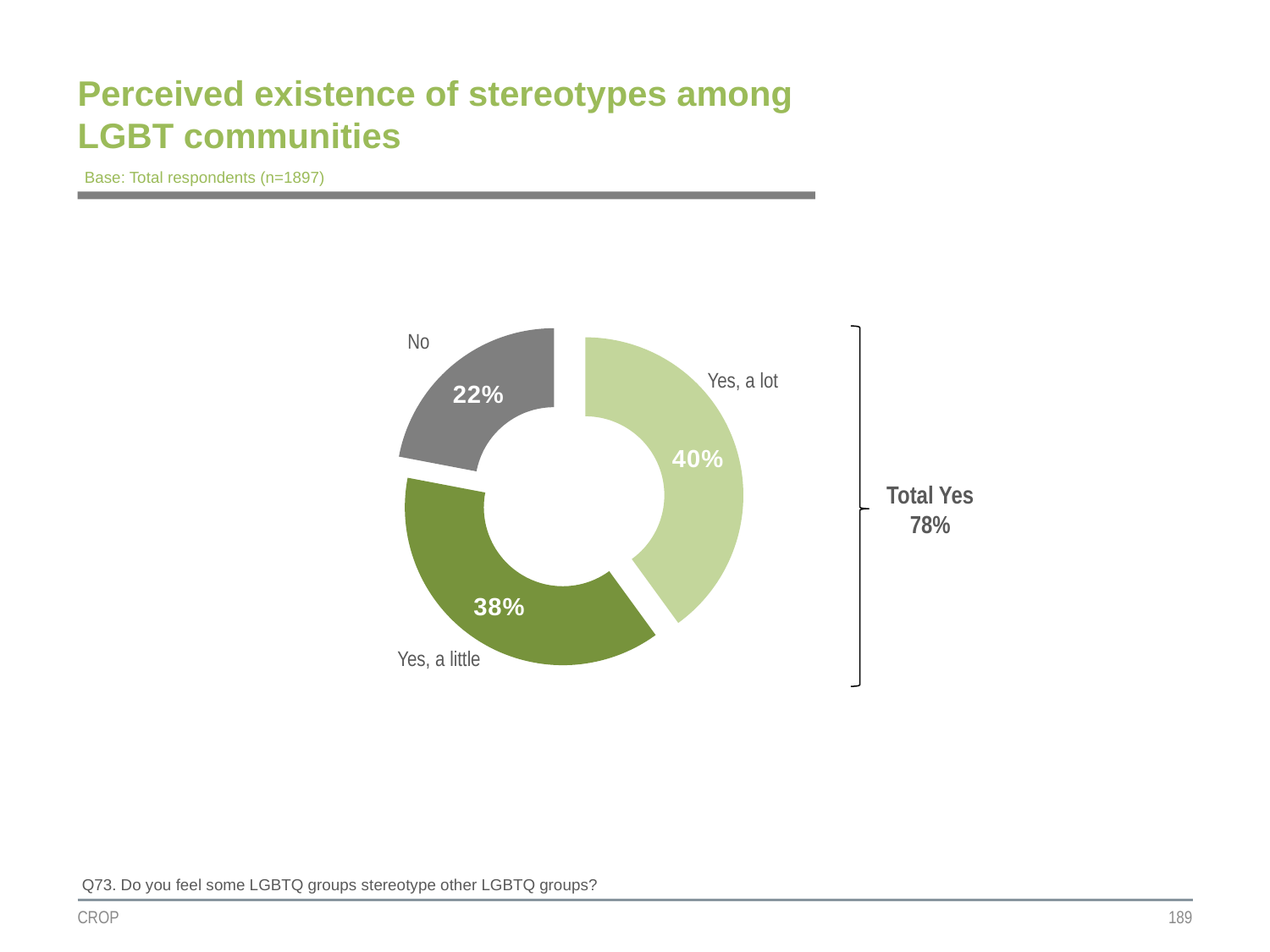
What is the title of the chart on the slide? Perceived existence of stereotypes among LGBT communities How many response categories are shown in the chart? 3 What kind of chart is shown on the slide? Doughnut (pie) chart Which response category has the largest share? Yes, a lot Which is larger, the share for "Yes, a little" or the share for "No"? Yes, a little What is the difference in percentage points between "Yes, a lot" and "No"? 18 What percentage of respondents answered "Yes, a little"? 38% What percentage of respondents answered "No"? 22% What is the combined share of the two "Yes" responses, as labelled on the slide? 78% Which response category has the smallest share? No What percentage of respondents answered "Yes, a lot"? 40% What is the base (number of respondents) stated on the slide? Total respondents (n=1897)